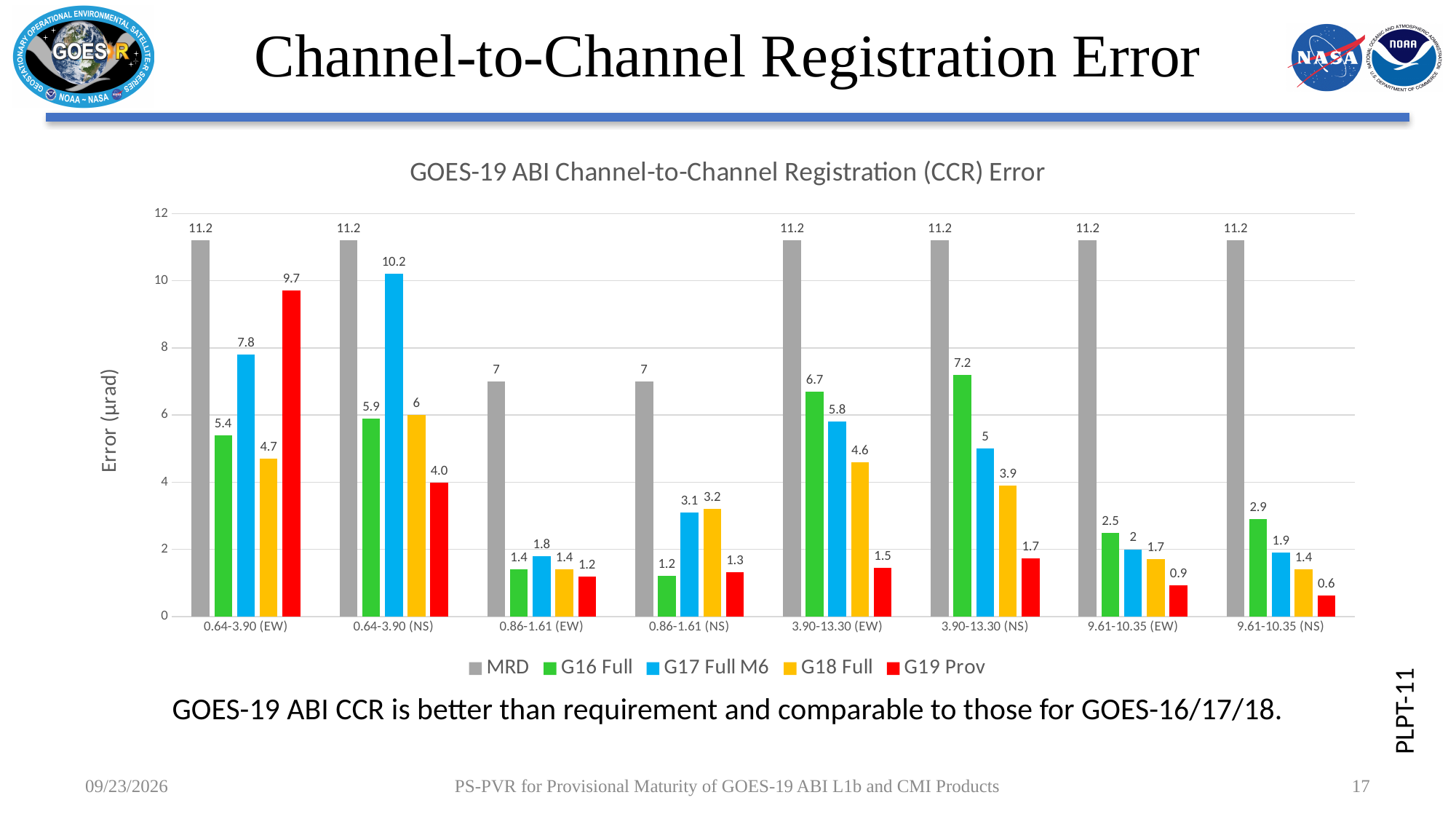
What kind of chart is shown on the slide? Bar chart Which category has the highest G16 Full value? 3.90-13.30 (NS) How many categories are shown on the x axis? 8 Which category has the lowest G19 Prov value? 9.61-10.35 (NS) Which is larger for 0.86-1.61 (NS): the G17 Full M6 value or the G18 Full value? G18 Full What is the G17 Full M6 value for 0.64-3.90 (NS)? 10.2 What is the G19 Prov value for 0.64-3.90 (EW)? 9.7 What is the label of the y axis? Error (μrad) What is the difference between the MRD value and the G19 Prov value for 3.90-13.30 (EW)? 9.7 What is the MRD value for 0.86-1.61 (NS)? 7 What is the title of the chart? GOES-19 ABI Channel-to-Channel Registration (CCR) Error How many series does the legend list? 5